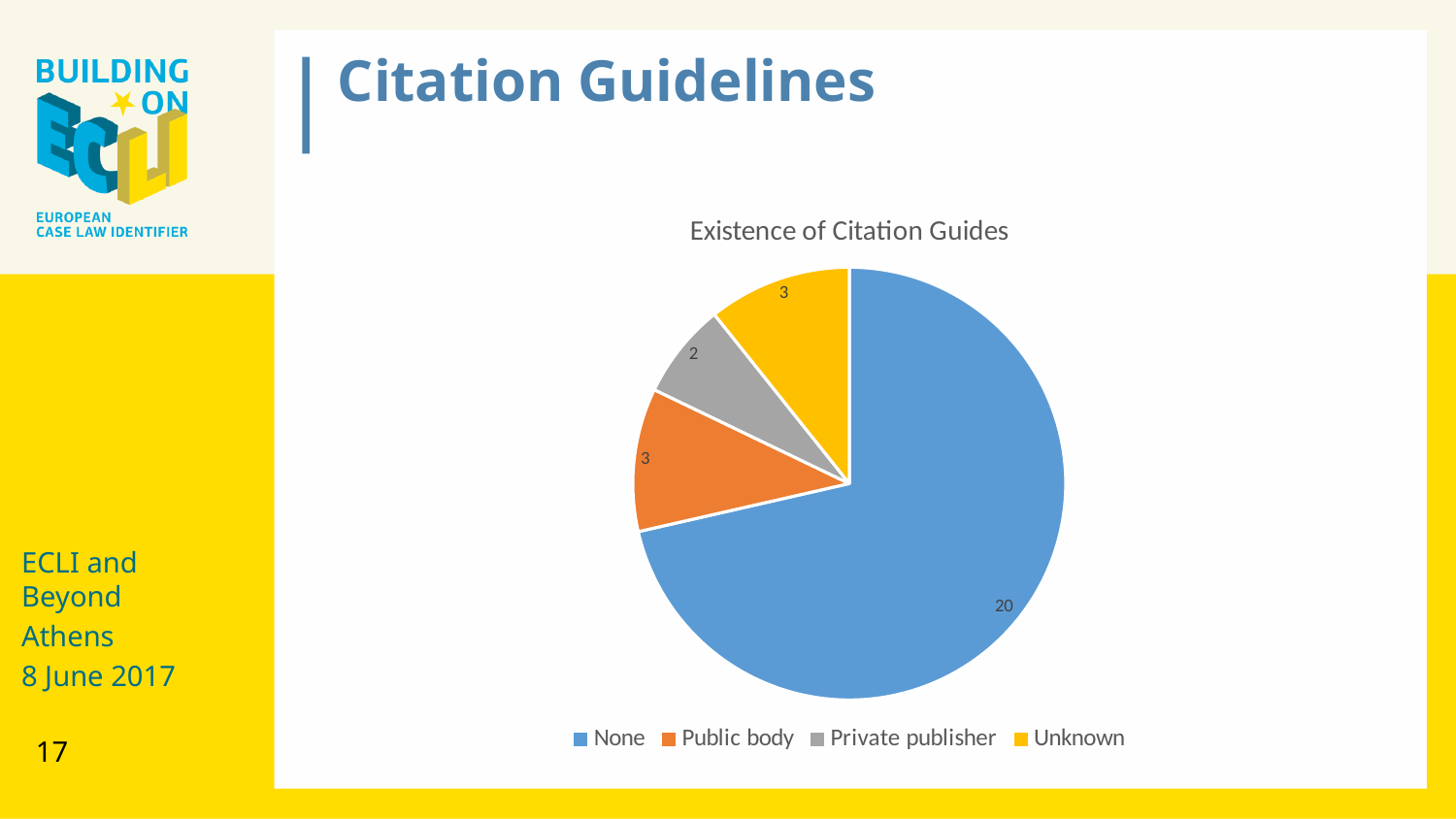
What is the value for the Public body slice? 3 What type of chart is shown on the slide? pie chart How many categories does the legend list? 4 What is the value for the None slice? 20 What is the total of all slices in the pie chart? 28 What is the value for the Private publisher slice? 2 Which category has the smallest slice? Private publisher Which category has the largest slice? None What is the title of the chart? Existence of Citation Guides Which is larger, the None slice or the Unknown slice? None What is the value for the Unknown slice? 3 What is the difference between the None value and the Public body value? 17